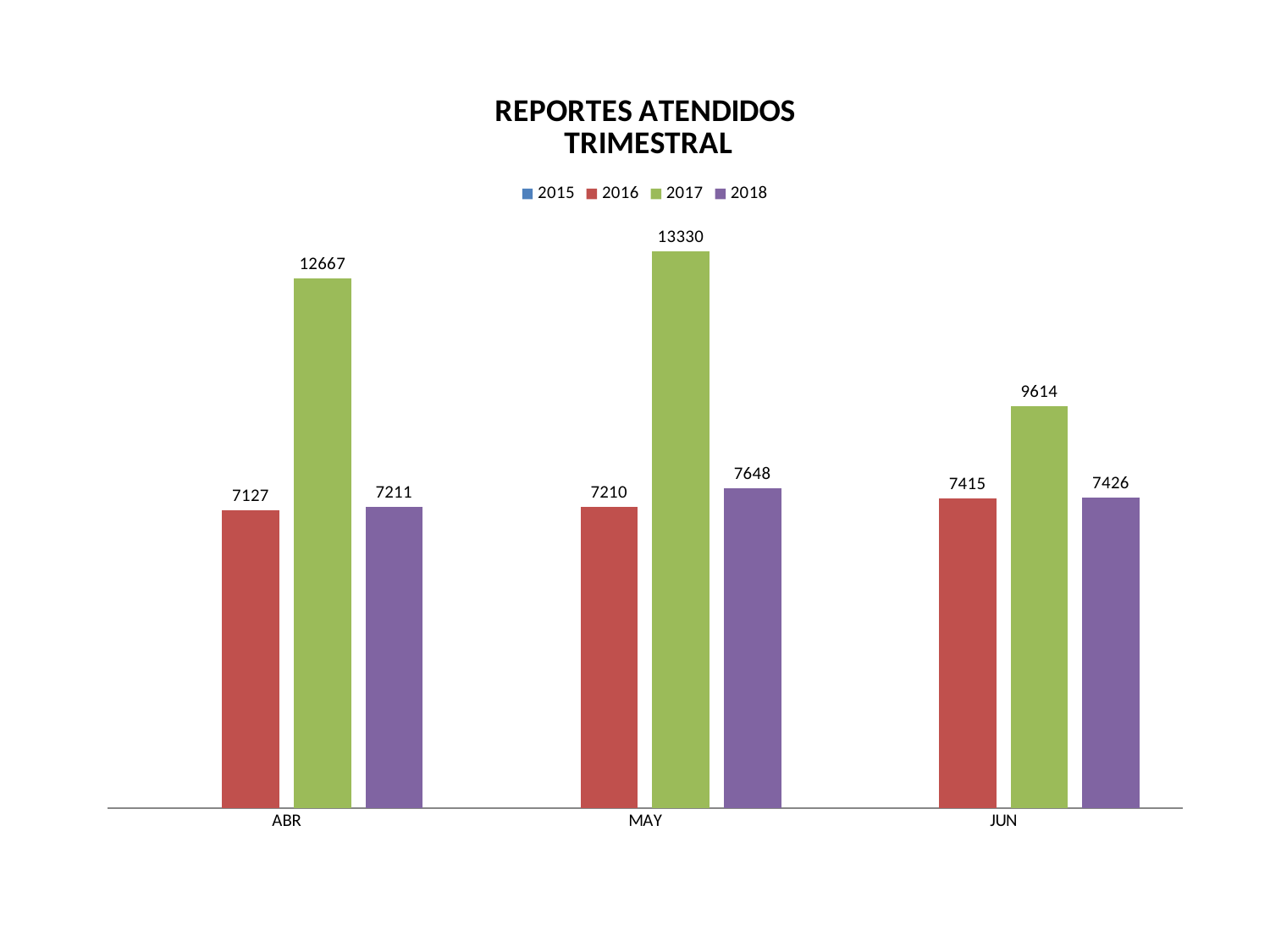
What kind of chart is this? bar chart What is the value for 2017 in MAY? 13330 What is the value for 2018 in JUN? 7426 What is the difference between the 2017 and 2018 values in MAY? 5682 Do the 2016 values rise or fall from ABR to JUN? rise Which month has the lowest value for 2016? ABR How many series does the legend list? 4 Which is larger in JUN, the 2017 value or the 2018 value? 2017 What is the difference between the 2017 values in ABR and JUN? 3053 Which month has the highest value for 2017? MAY How many months are shown on the x axis? 3 What is the value for 2016 in ABR? 7127